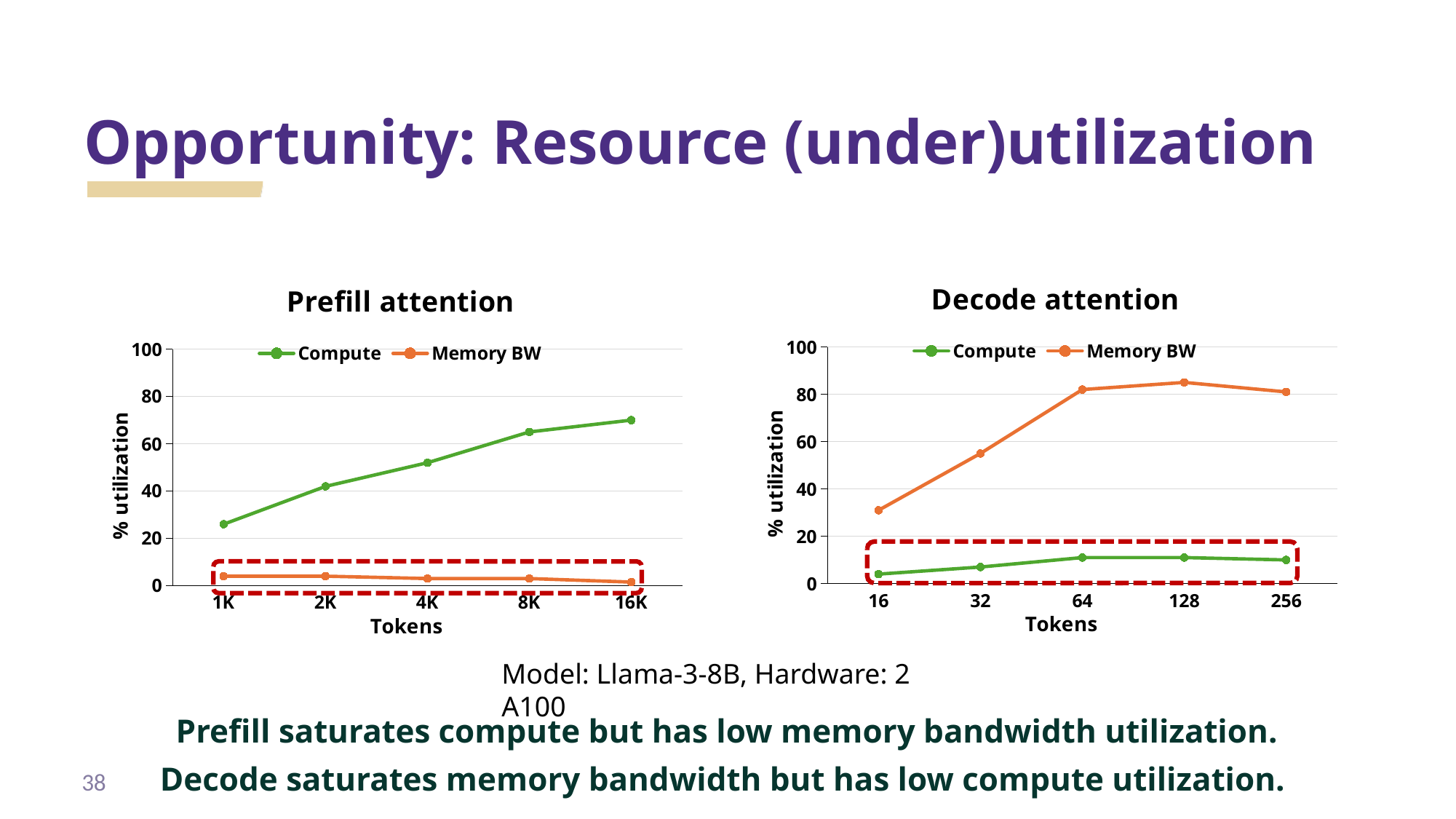
In the Prefill attention chart, does the Compute series rise or fall as tokens increase from 1K to 16K? rise What is the label of the y axis on the Decode attention chart? % utilization In the Prefill attention chart, at which token count is Compute utilization highest? 16K In the Decode attention chart, is the Compute value at 256 greater or less than 20? less How many token values are plotted along the x axis of the Prefill attention chart? 5 What kind of chart is the Prefill attention chart? line chart In the Prefill attention chart, is the Compute value at 16K greater or less than 60? greater In the Prefill attention chart, is the Compute value at 1K greater or less than 40? less How many series does the legend of the Decode attention chart list? 2 In the Decode attention chart, which series is higher at 64 tokens, Compute or Memory BW? Memory BW In the Decode attention chart, at which token count is Memory BW utilization lowest? 16